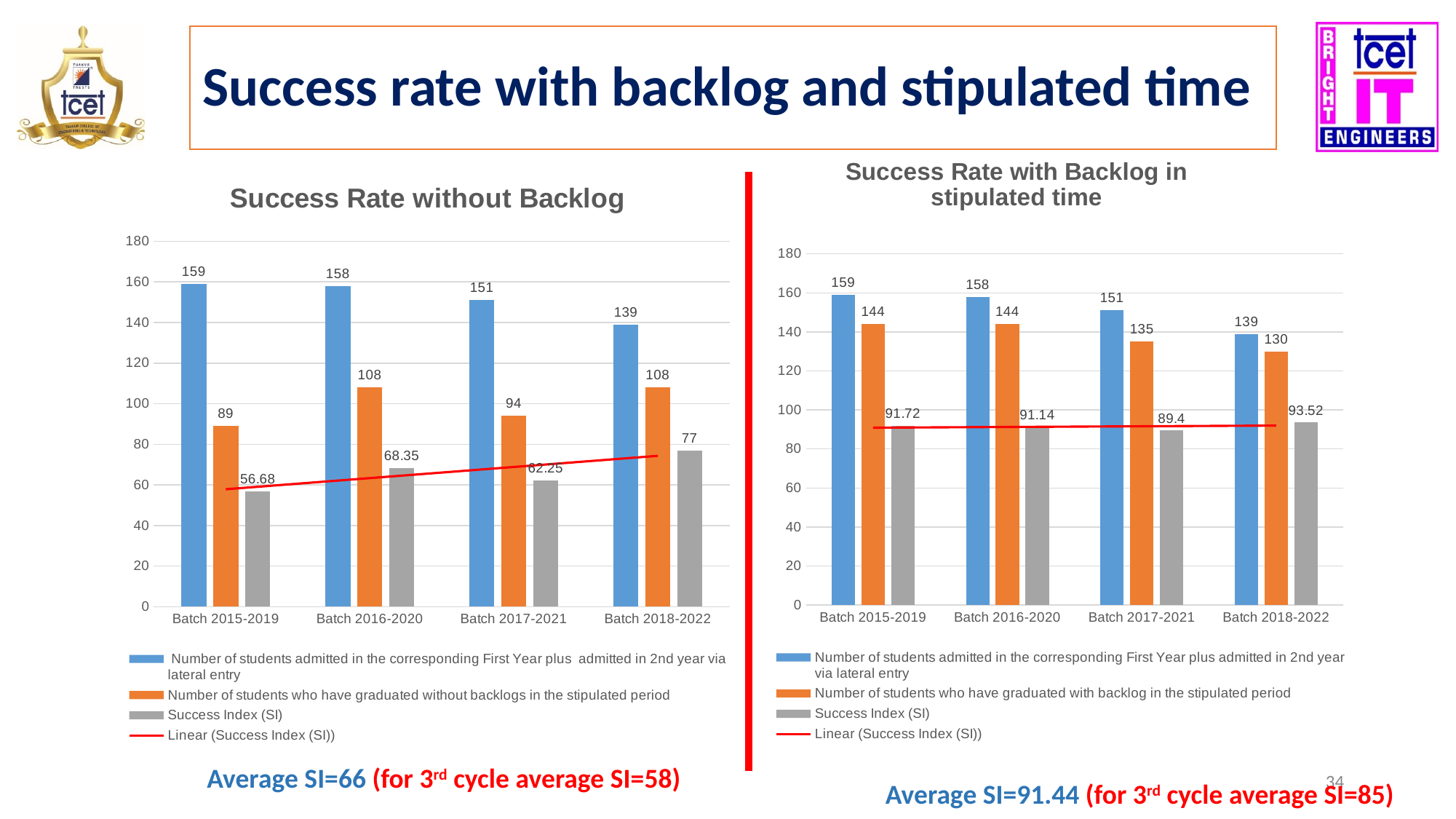
In the 'Success Rate with Backlog in stipulated time' chart, is the Success Index (SI) for Batch 2017-2021 greater or less than 100? less How many entries does the legend of the 'Success Rate with Backlog in stipulated time' chart list? 4 In the 'Success Rate without Backlog' chart, how many students graduated without backlogs in Batch 2015-2019? 89 In the 'Success Rate with Backlog in stipulated time' chart, is the number of students who graduated with backlog larger for Batch 2015-2019 or Batch 2018-2022? Batch 2015-2019 What type of chart is the 'Success Rate without Backlog' chart? Bar chart In the 'Success Rate with Backlog in stipulated time' chart, how many students graduated with backlog in Batch 2017-2021? 135 In the 'Success Rate without Backlog' chart, which batch has the lowest Success Index (SI)? Batch 2015-2019 In the 'Success Rate with Backlog in stipulated time' chart, which batch has the highest Success Index (SI)? Batch 2018-2022 In the 'Success Rate without Backlog' chart, what is the Success Index (SI) for Batch 2016-2020? 68.35 How many batches are shown on the x axis of the 'Success Rate without Backlog' chart? 4 In the 'Success Rate without Backlog' chart, what is the difference between the number of students admitted and the number who graduated without backlogs for Batch 2018-2022? 31 In the 'Success Rate without Backlog' chart, does the number of students admitted rise or fall from Batch 2015-2019 to Batch 2018-2022? Fall